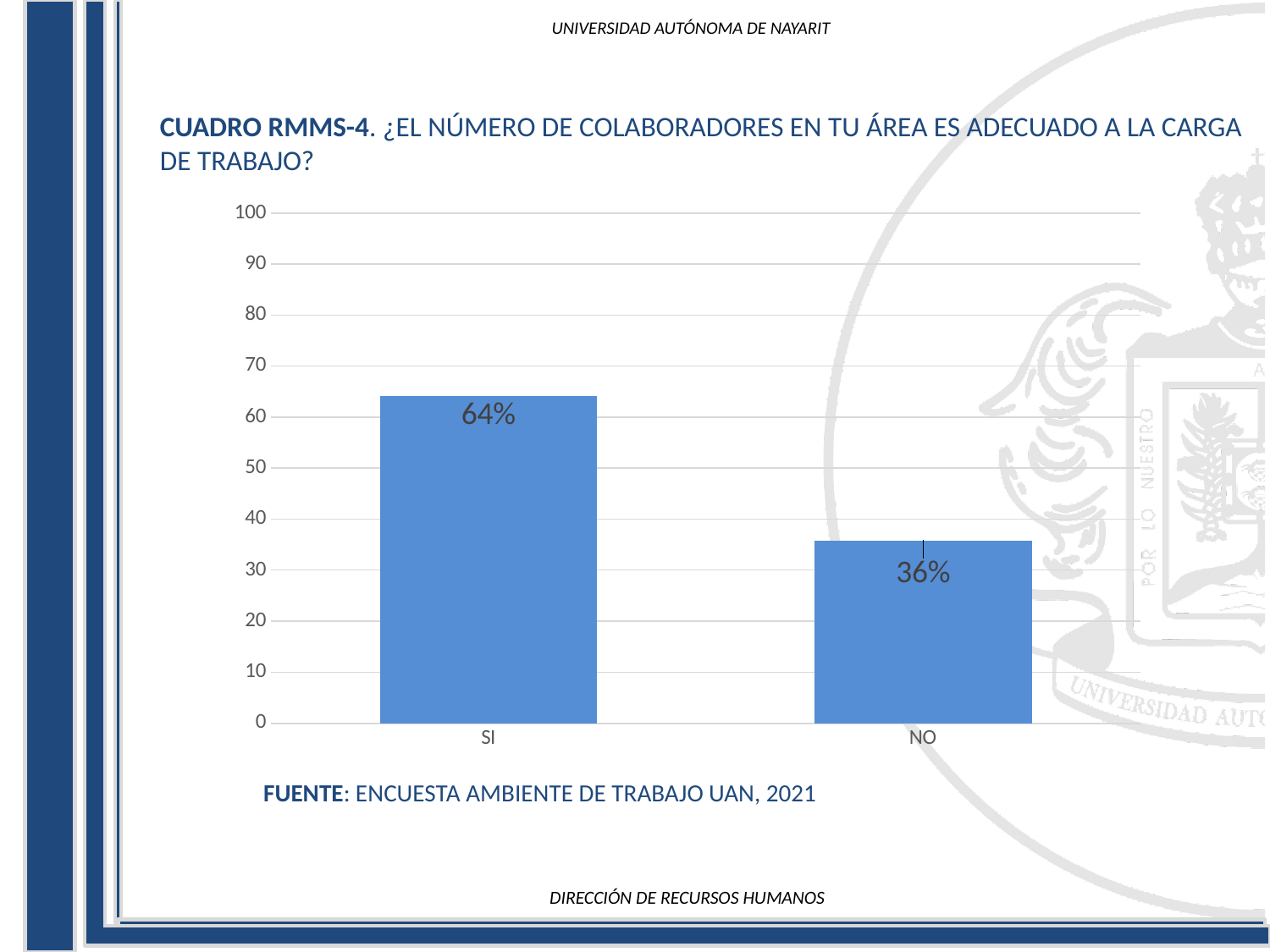
What is the value for NO? 36% Is the value for NO greater or less than 40? less What kind of chart is shown on the slide? bar chart Is the value for SI greater or less than 50? greater Which category has the highest value? SI What is the maximum value shown on the y axis? 100 How many categories are shown on the x axis? 2 Which is larger, the value for SI or the value for NO? SI What is the value for SI? 64% Which category has the lowest value? NO What is the difference between the values for SI and NO? 28% What is the source cited below the chart? ENCUESTA AMBIENTE DE TRABAJO UAN, 2021